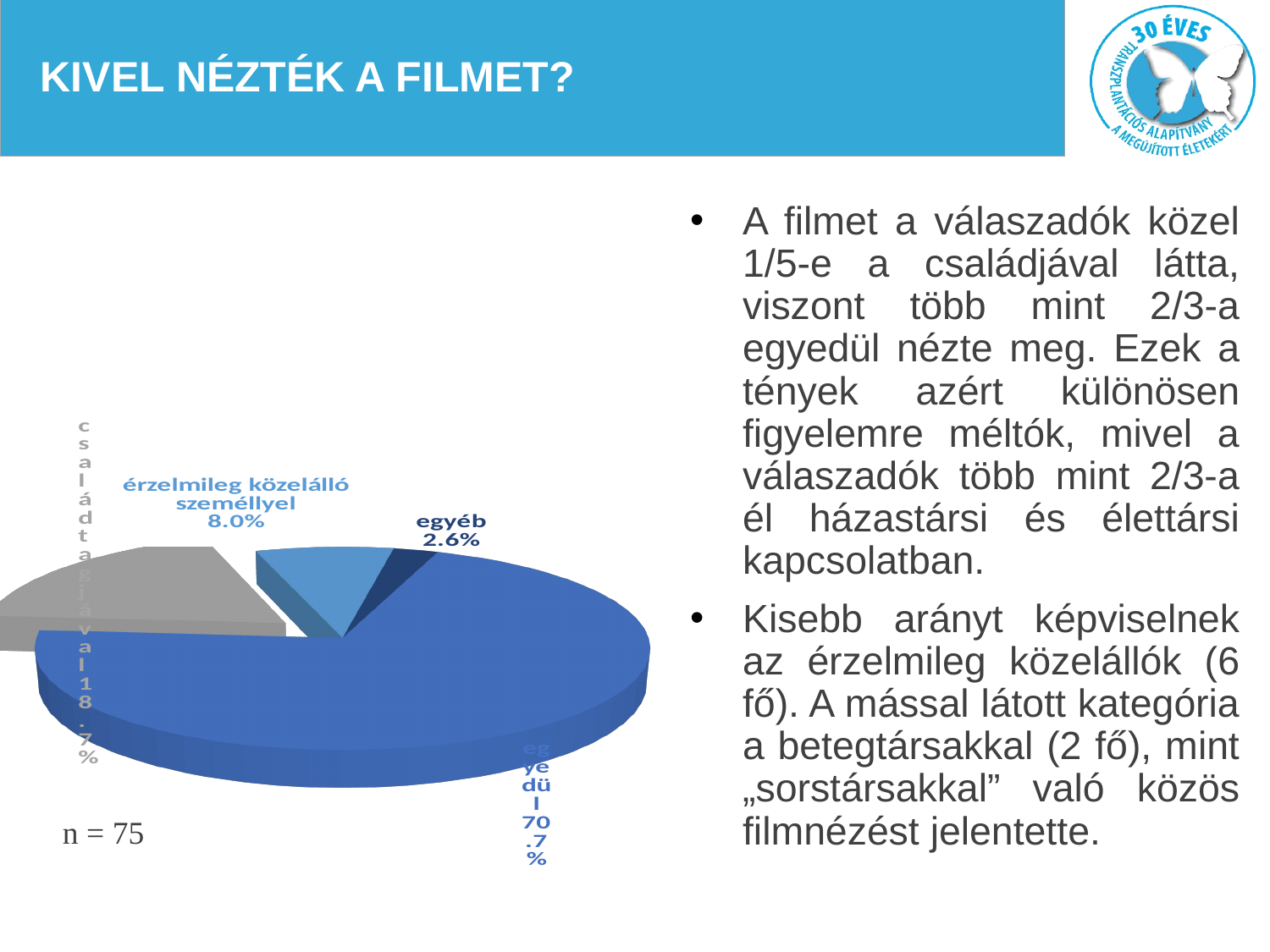
What share of the pie does the "egyedül" slice represent? 70.7% What percentage is shown for "érzelmileg közelálló személlyel"? 8.0% What percentage is shown for the "egyéb" slice? 2.6% What is the combined percentage of the "érzelmileg közelálló személlyel" and "egyéb" slices? 10.6% Which is larger, the "családtagjával" slice or the "érzelmileg közelálló személlyel" slice? családtagjával What sample size (n) is stated below the chart? n = 75 How many slices does the pie chart have? 4 What kind of chart is shown on the slide? pie chart What is the difference in percentage points between the "egyedül" and "családtagjával" slices? 52.0 Which category has the largest slice of the pie? egyedül What percentage is shown for the "családtagjával" slice? 18.7% Which category has the smallest slice of the pie? egyéb